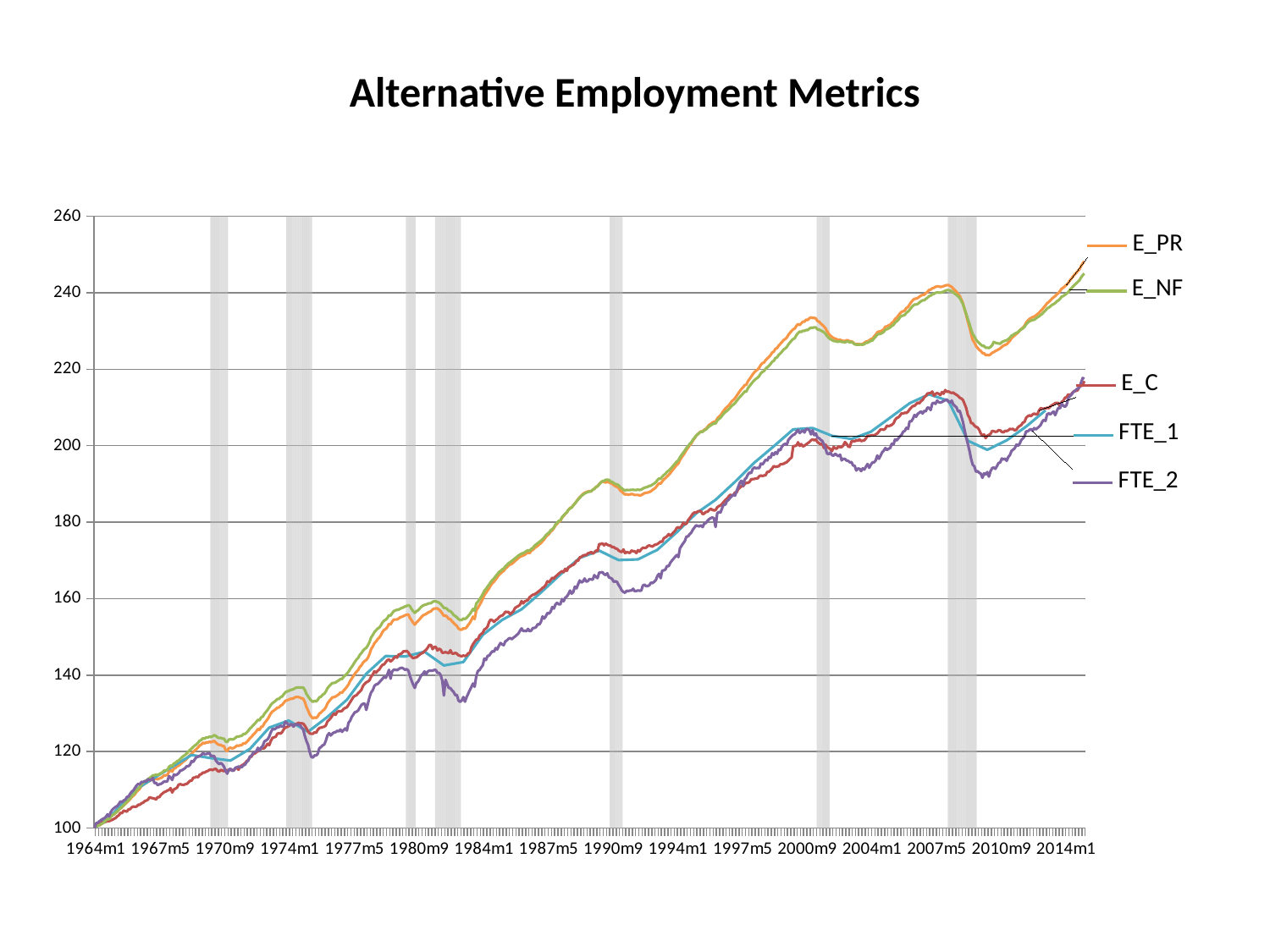
At the right end of the chart, which series is higher, E_PR or FTE_2? E_PR Is the value of E_PR at 2007m5 greater or less than 220? greater Which series is the lowest around 2010m9? FTE_2 What is the highest value shown on the y axis? 260 Is the value of FTE_2 at 2010m9 greater or less than 200? less Do the series generally rise or fall from 1964m1 to 2014m1? rise How many series does the legend list? 5 Is the value of E_C at 1984m1 greater or less than 160? less What kind of chart is shown on the slide? line chart What value do all the series start at in 1964m1? 100 Which series reaches the highest value at the right end of the chart? E_PR What is the title of the chart? Alternative Employment Metrics